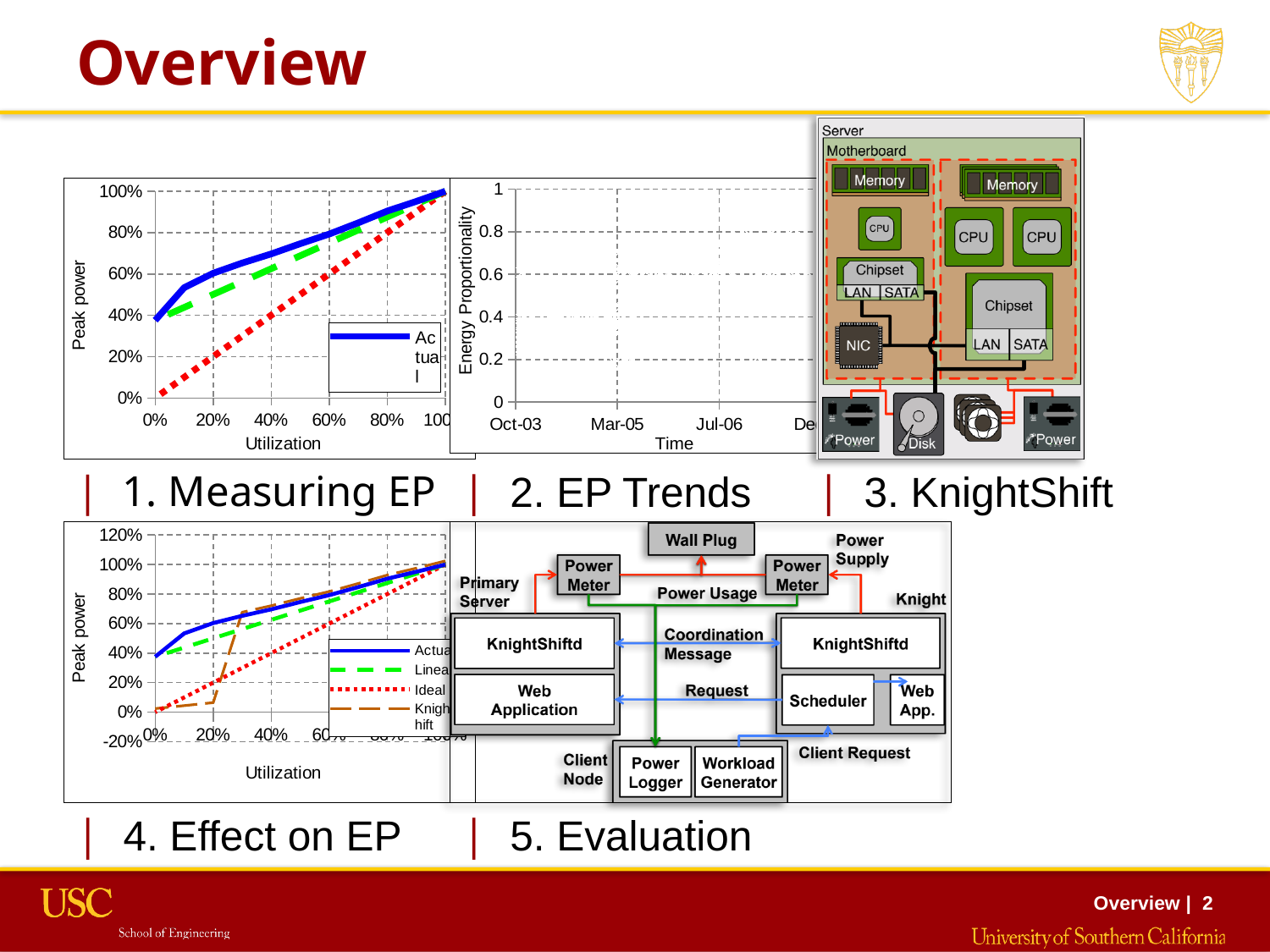
What is the y-axis label of the chart above "2. EP Trends"? Energy Proportionality In the chart above "4. Effect on EP", is the value of the KnightShift series at 20% utilization greater or less than 40%? less What is the x-axis label of the chart above "1. Measuring EP"? Utilization In the chart above "1. Measuring EP", what is the value of the Actual series at 100% utilization? 100% What kind of chart is the chart above the label "1. Measuring EP"? line chart In the chart above "1. Measuring EP", what is the value of the Ideal series at 0% utilization? 0% In the chart above "1. Measuring EP", is the value of the Actual series at 0% utilization greater or less than 20%? greater How many series does the legend list in the chart above "4. Effect on EP"? 4 In the chart above "1. Measuring EP", does the Actual series rise or fall as utilization increases? rise In the chart above "1. Measuring EP", at 20% utilization, which series is larger: Actual or Ideal? Actual In the chart above "1. Measuring EP", how many lines are plotted? 3 In the chart above "4. Effect on EP", is the value of the Actual series at 40% utilization greater or less than 40%? greater